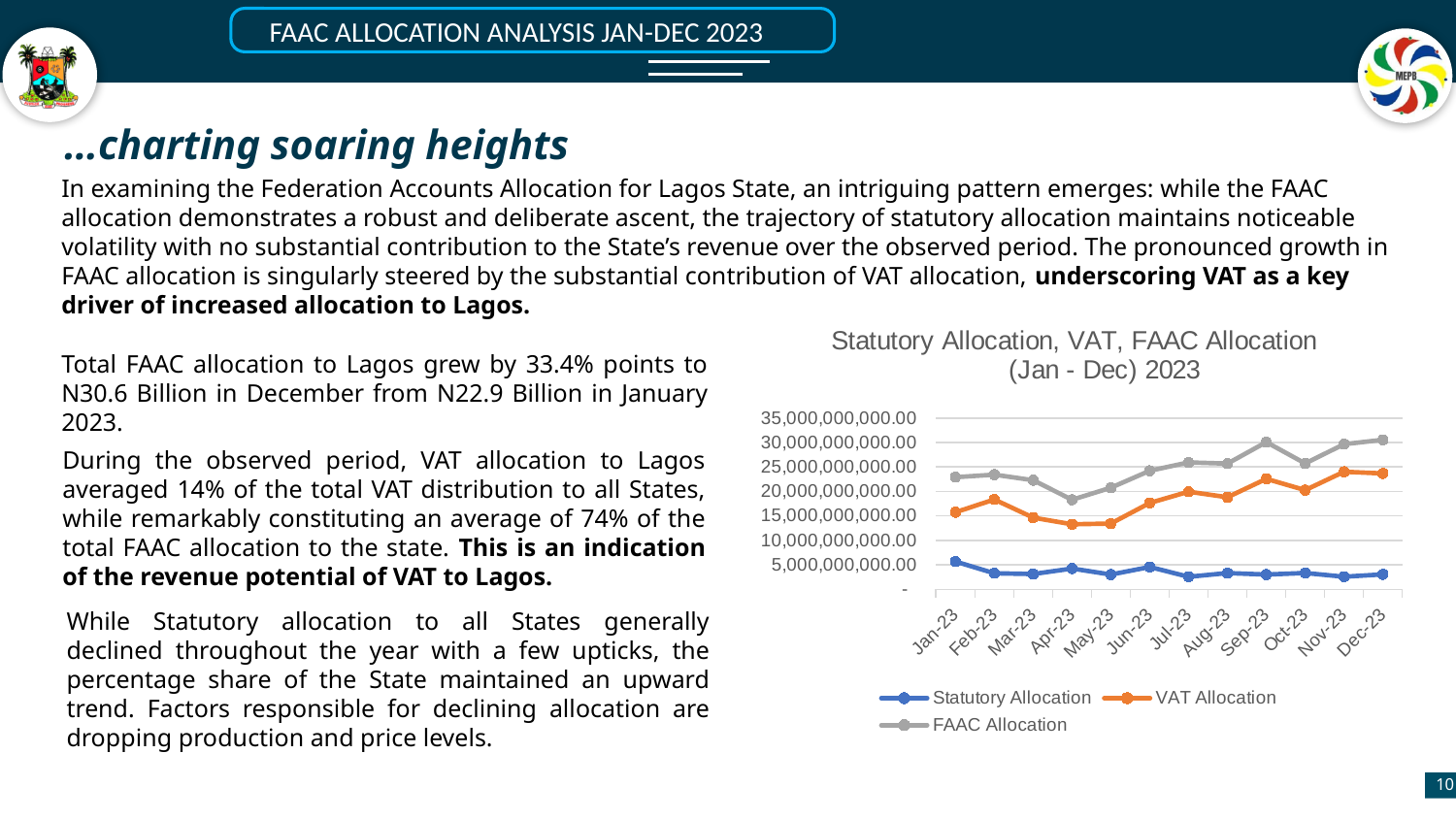
What is the title of the chart? Statutory Allocation, VAT, FAAC Allocation (Jan - Dec) 2023 Is the VAT Allocation for Dec-23 greater or less than 20,000,000,000.00? greater In which month is the Statutory Allocation highest? Jan-23 How many series does the chart legend list? 3 Which is larger, the FAAC Allocation in Jan-23 or in Apr-23? Jan-23 How many months are plotted along the x axis of the chart? 12 Is the Statutory Allocation for Jul-23 greater or less than 5,000,000,000.00? less Is the FAAC Allocation for Apr-23 greater or less than 20,000,000,000.00? less Which series is drawn in grey in the chart? FAAC Allocation Does the FAAC Allocation overall rise or fall from Jan-23 to Dec-23? Rise In which month is the FAAC Allocation lowest? Apr-23 What kind of chart is shown on the slide? Line chart